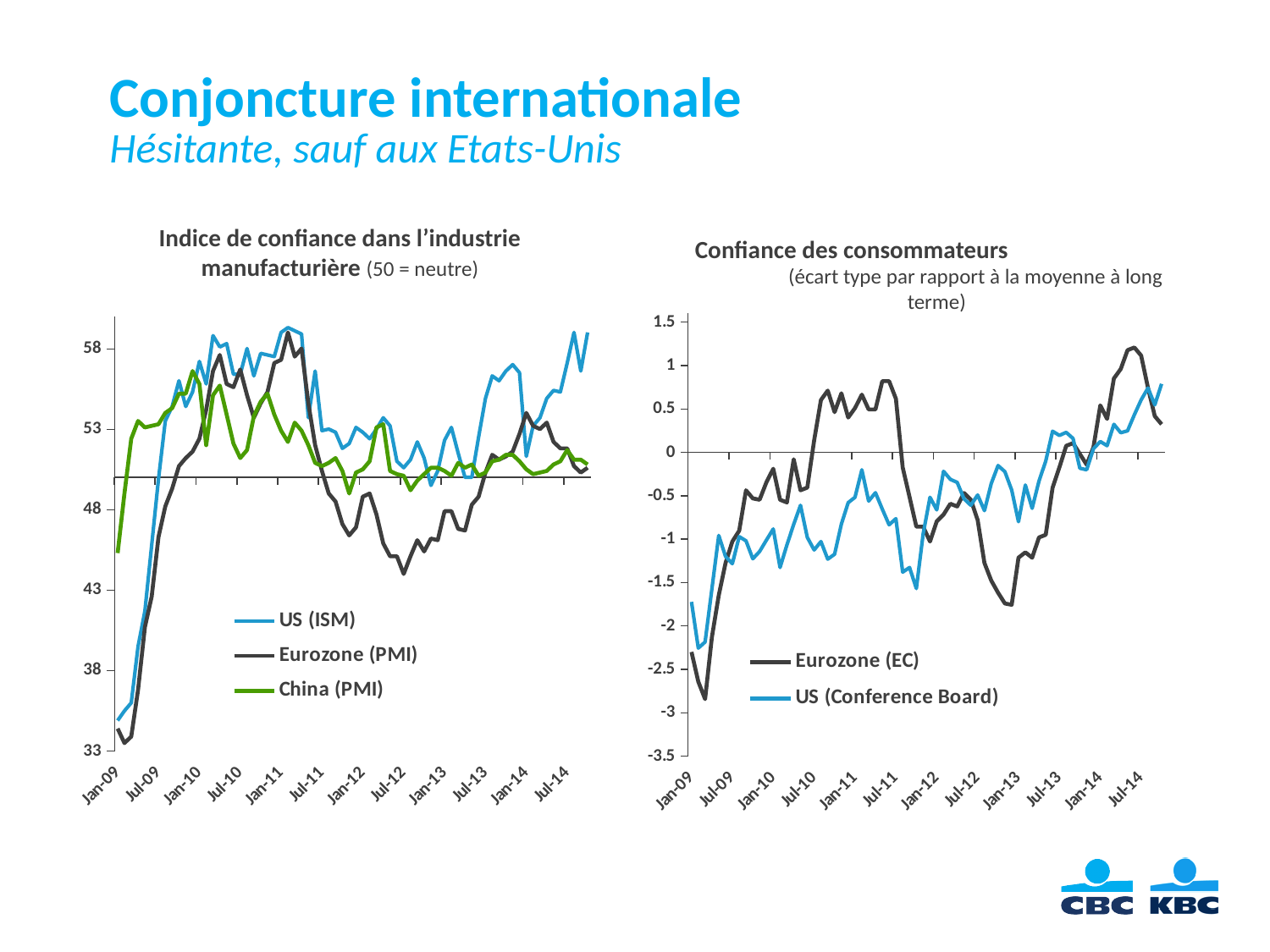
In the right chart, 'Confiance des consommateurs', is the value for Eurozone (EC) at Jan-13 greater or less than -1.5? greater In the left chart, 'Indice de confiance dans l'industrie manufacturière', which series is drawn in green? China (PMI) In the right chart, 'Confiance des consommateurs', what are the two series named in the legend? Eurozone (EC) and US (Conference Board) In the left chart, 'Indice de confiance dans l'industrie manufacturière', is the value for US (ISM) at Jan-09 greater or less than 38? less In the left chart, 'Indice de confiance dans l'industrie manufacturière', is the value for Eurozone (PMI) at Jul-12 greater or less than 48? less What kind of chart is the left chart, 'Indice de confiance dans l'industrie manufacturière'? Line chart How many series does the legend of the left chart, 'Indice de confiance dans l'industrie manufacturière', list? 3 In the right chart, 'Confiance des consommateurs', does the Eurozone (EC) series rise or fall between Jan-13 and Jul-14? Rise How many series does the legend of the right chart, 'Confiance des consommateurs', list? 2 In the left chart, 'Indice de confiance dans l'industrie manufacturière', which series has the higher value at Jan-09, China (PMI) or US (ISM)? China (PMI)